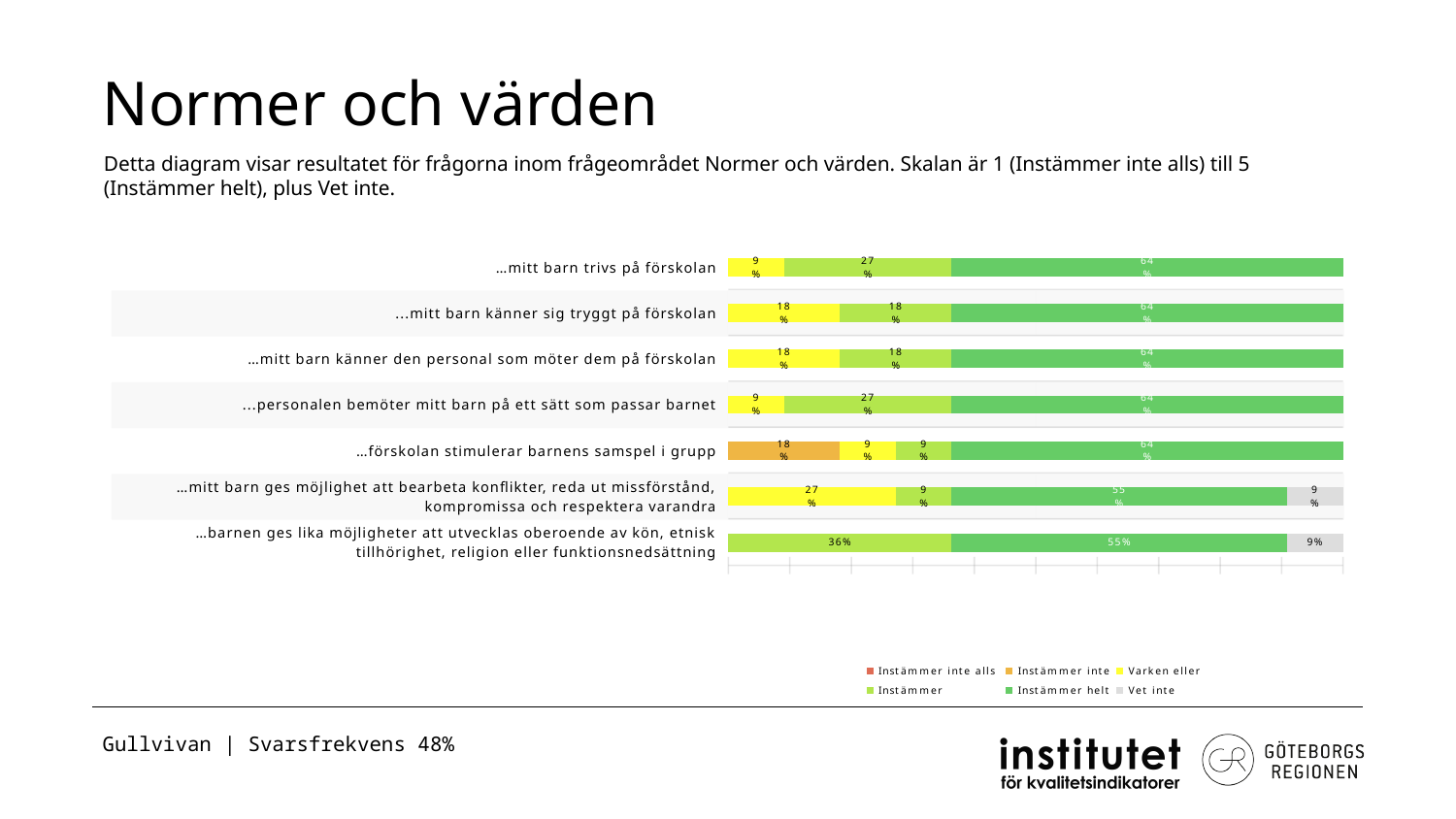
What is the 'Instämmer helt' value for '…mitt barn trivs på förskolan'? 64% What is the 'Instämmer' value for '…barnen ges lika möjligheter att utvecklas oberoende av kön, etnisk tillhörighet, religion eller funktionsnedsättning'? 36% What is the 'Instämmer helt' value for '…barnen ges lika möjligheter att utvecklas oberoende av kön, etnisk tillhörighet, religion eller funktionsnedsättning'? 55% Which is larger: the 'Instämmer helt' value for '…mitt barn känner sig tryggt på förskolan' or for '…barnen ges lika möjligheter att utvecklas oberoende av kön, etnisk tillhörighet, religion eller funktionsnedsättning'? …mitt barn känner sig tryggt på förskolan What is the title of the slide containing the chart? Normer och värden How many questions (categories) are plotted in the chart? 7 What is the 'Vet inte' value for '…mitt barn ges möjlighet att bearbeta konflikter, reda ut missförstånd, kompromissa och respektera varandra'? 9% What is the difference between the 'Instämmer' value for '…barnen ges lika möjligheter att utvecklas oberoende av kön, etnisk tillhörighet, religion eller funktionsnedsättning' (36%) and the 'Instämmer' value for '…mitt barn trivs på förskolan' (27%)? 9% How many series does the legend list? 6 What kind of chart is shown on the slide? Stacked bar chart What is the total of the labelled segments for '…mitt barn känner sig tryggt på förskolan' (18%, 18%, 64%)? 100% What is the 'Instämmer inte' value for '…förskolan stimulerar barnens samspel i grupp'? 18%